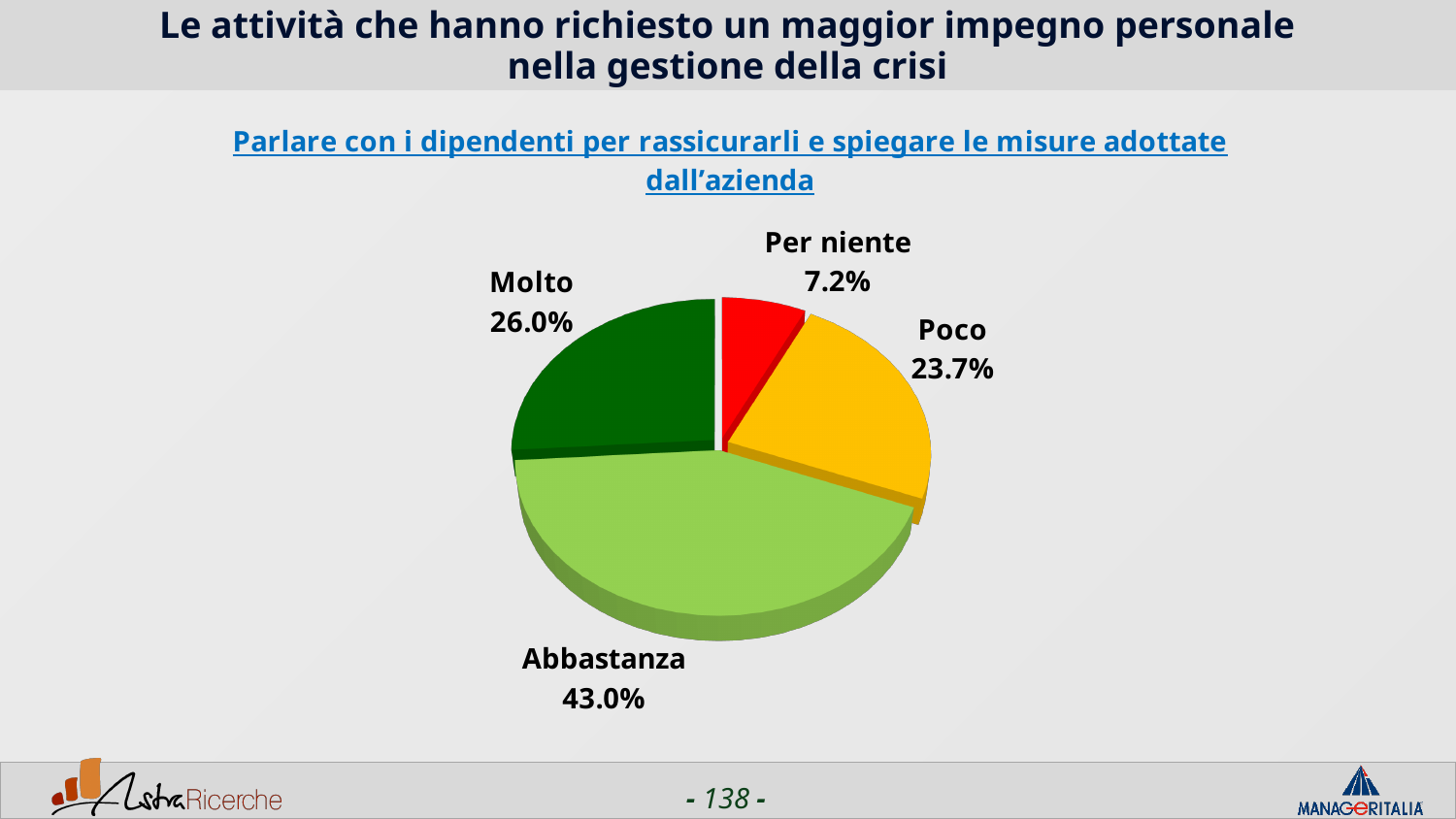
Which category has the largest slice? Abbastanza How many slices does the pie chart have? 4 What is the value for Abbastanza? 43.0% What is the value for Per niente? 7.2% What colour is the Per niente slice? red Which category has the smallest slice? Per niente What is the difference between the values for Abbastanza and Molto? 17.0% What is the value for Poco? 23.7% What kind of chart is shown on the slide? pie chart What is the difference between the values for Poco and Per niente? 16.5% Which is larger, the value for Molto or the value for Poco? Molto What is the value for Molto? 26.0%